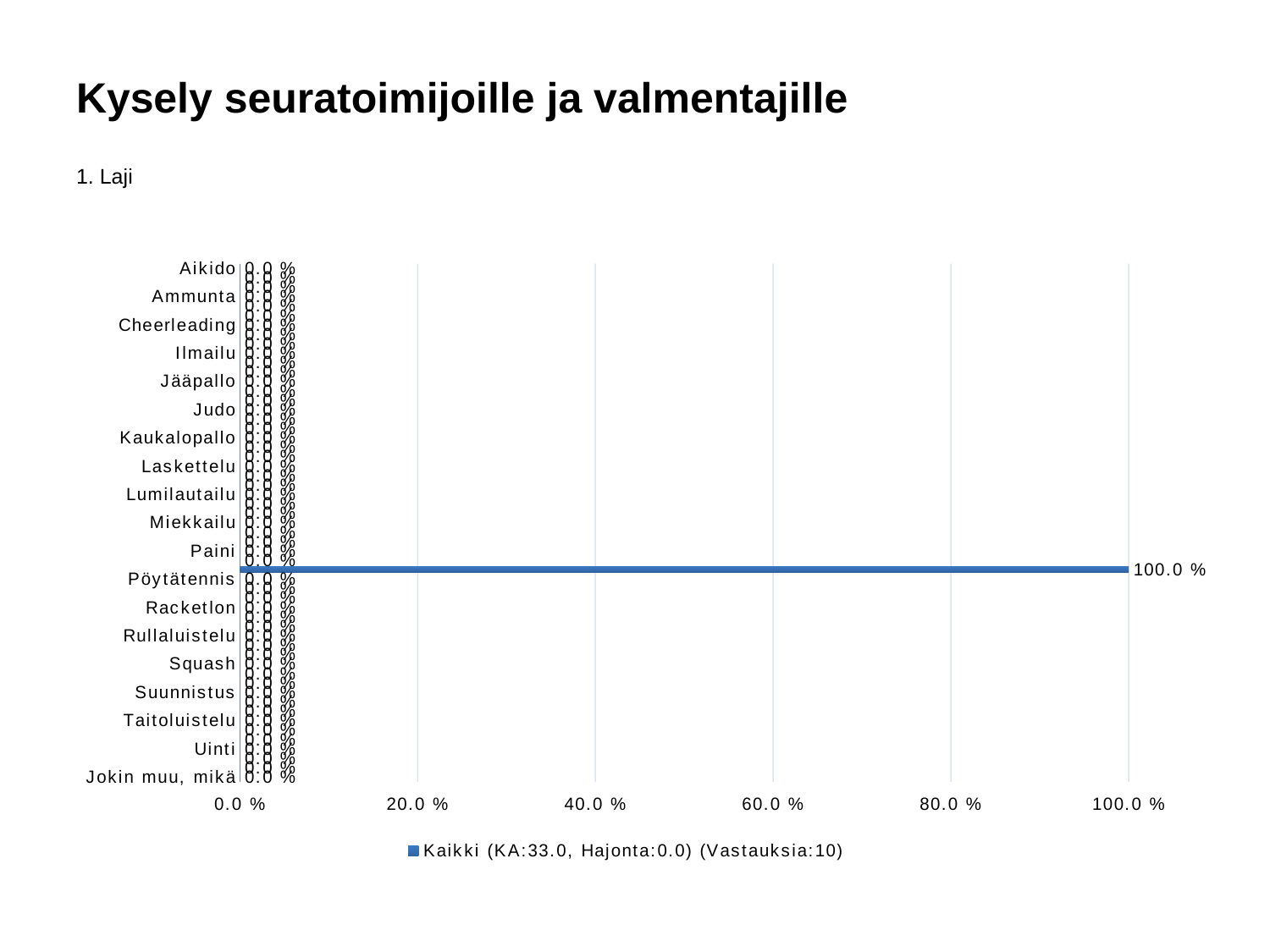
Is the value for Miekkailu greater or less than 20.0 %? less What is the difference between the values for Pöytätennis and Aikido? 0.0 % What is the title of the slide? Kysely seuratoimijoille ja valmentajille Is the value for Pöytätennis greater or less than 80.0 %? less What kind of chart is shown on the slide? bar chart How many series does the legend list? 1 What is the value for Pöytätennis? 0.0 % What is the value for Squash? 0.0 % What is the value for Judo? 0.0 % What is the legend entry of the series shown in the chart? Kaikki (KA:33.0, Hajonta:0.0) (Vastauksia:10)